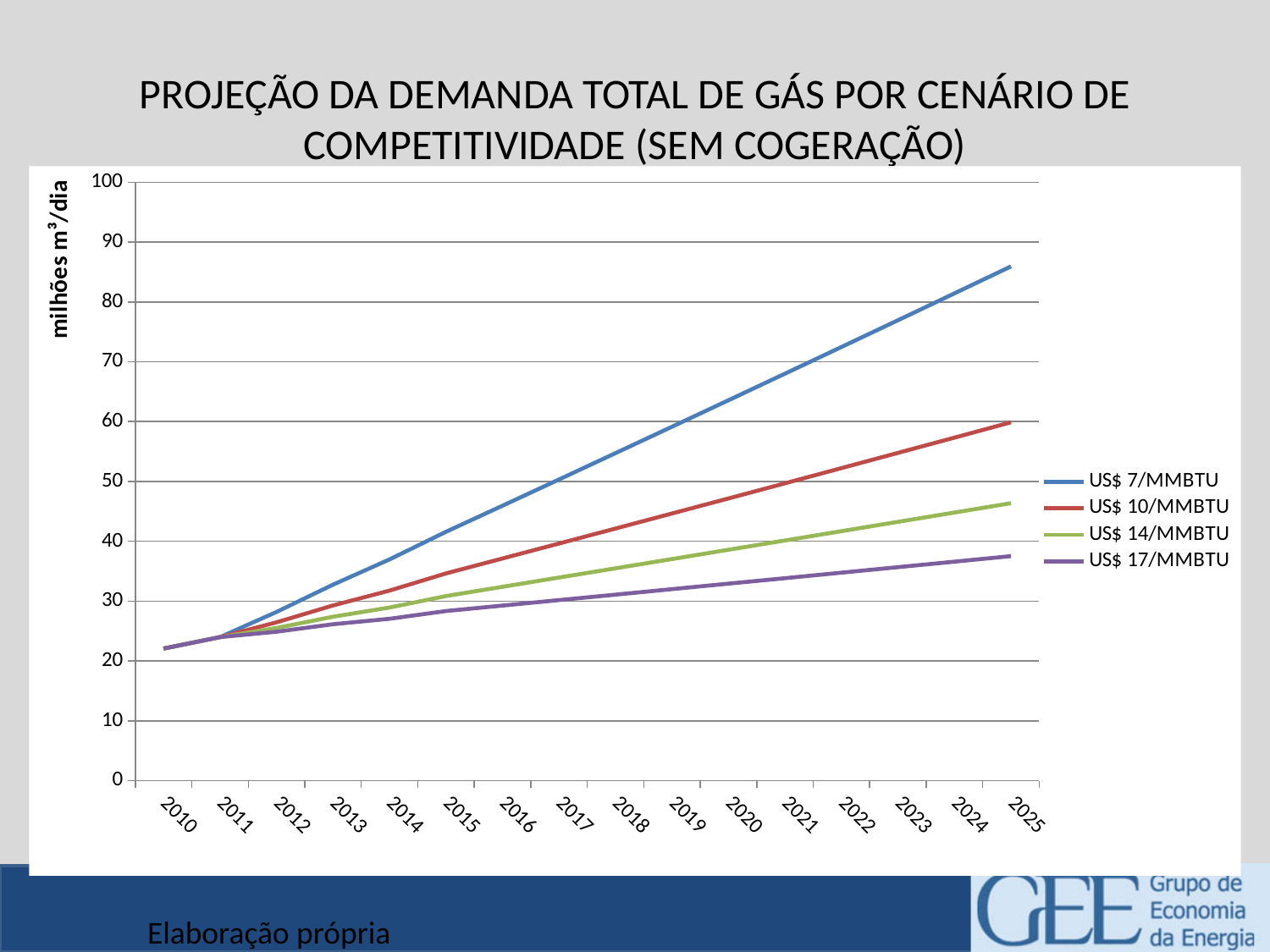
How many years are shown along the x axis? 16 Is the value for US$ 17/MMBTU in 2025 greater or less than 40? less Is the value for US$ 7/MMBTU in 2022 greater or less than 70? greater Which series has the lowest value in 2025? US$ 17/MMBTU Do the values for US$ 7/MMBTU rise or fall from 2010 to 2025? rise In 2025, which is larger: the value for US$ 10/MMBTU or the value for US$ 14/MMBTU? US$ 10/MMBTU Which series has the highest value in 2025? US$ 7/MMBTU Is the value for US$ 7/MMBTU in 2025 greater or less than 80? greater How many series does the legend list? 4 What is the label on the y axis? milhões m³/dia What kind of chart is shown on the slide? line chart